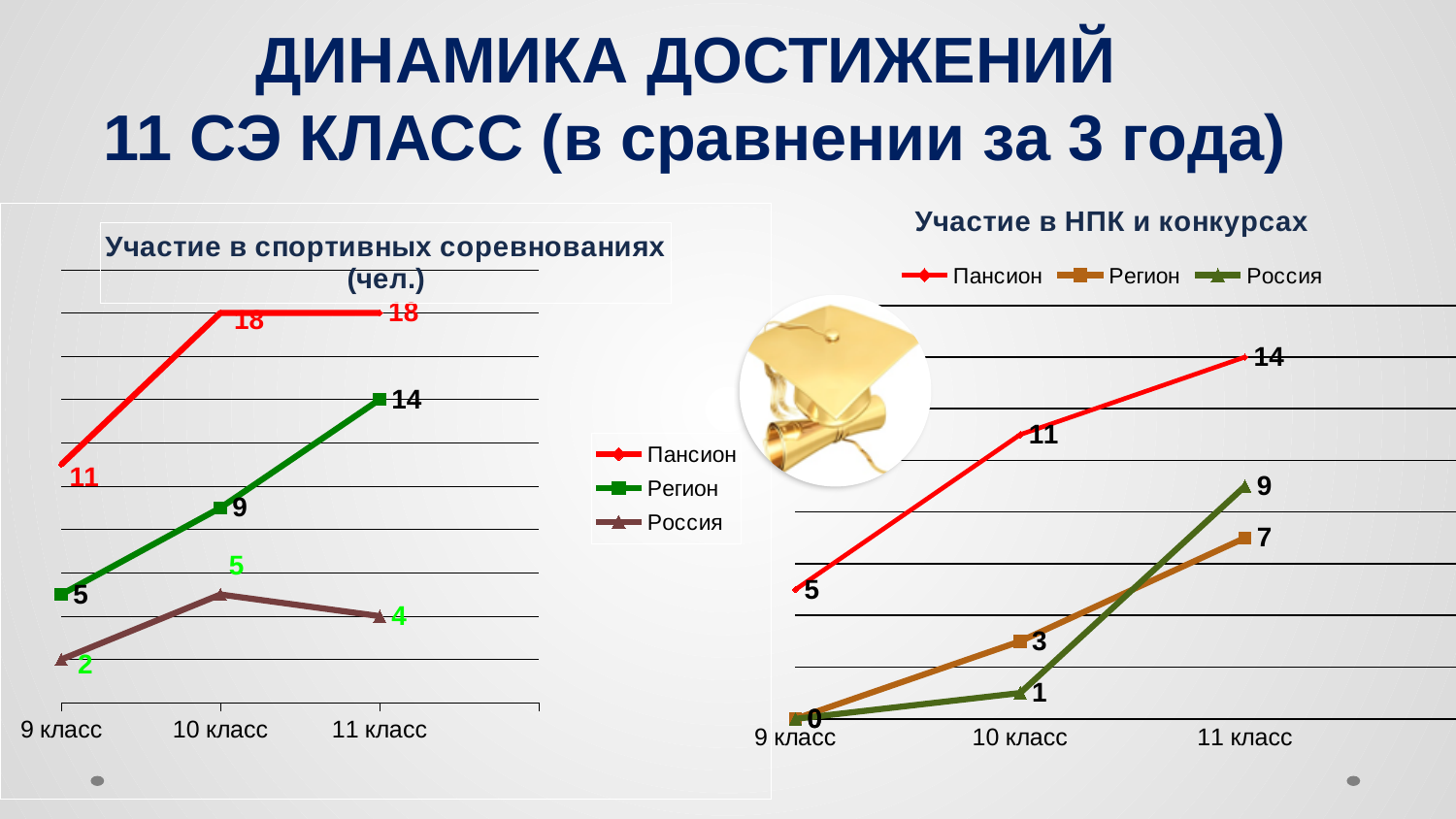
On the chart 'Участие в НПК и конкурсах', what is the difference between Пансион and Регион in 11 класс? 7 On the chart 'Участие в НПК и конкурсах', which is larger in 11 класс, Регион or Россия? Россия How many series does the legend of the chart 'Участие в НПК и конкурсах' list? 3 On the chart 'Участие в НПК и конкурсах', what is the value for Россия in 11 класс? 9 What kind of chart is 'Участие в спортивных соревнованиях (чел.)'? line chart On the chart 'Участие в спортивных соревнованиях (чел.)', what is the difference between Пансион and Регион in 11 класс? 4 On the chart 'Участие в НПК и конкурсах', what is the value for Пансион in 10 класс? 11 On the chart 'Участие в спортивных соревнованиях (чел.)', what is the value for Россия in 9 класс? 2 On the chart 'Участие в спортивных соревнованиях (чел.)', does the Россия series rise or fall from 10 класс to 11 класс? fall On the chart 'Участие в спортивных соревнованиях (чел.)', which series has the lowest value in 11 класс? Россия On the chart 'Участие в спортивных соревнованиях (чел.)', what is the value for Регион in 10 класс? 9 On the chart 'Участие в спортивных соревнованиях (чел.)', what is the value for Пансион in 11 класс? 18